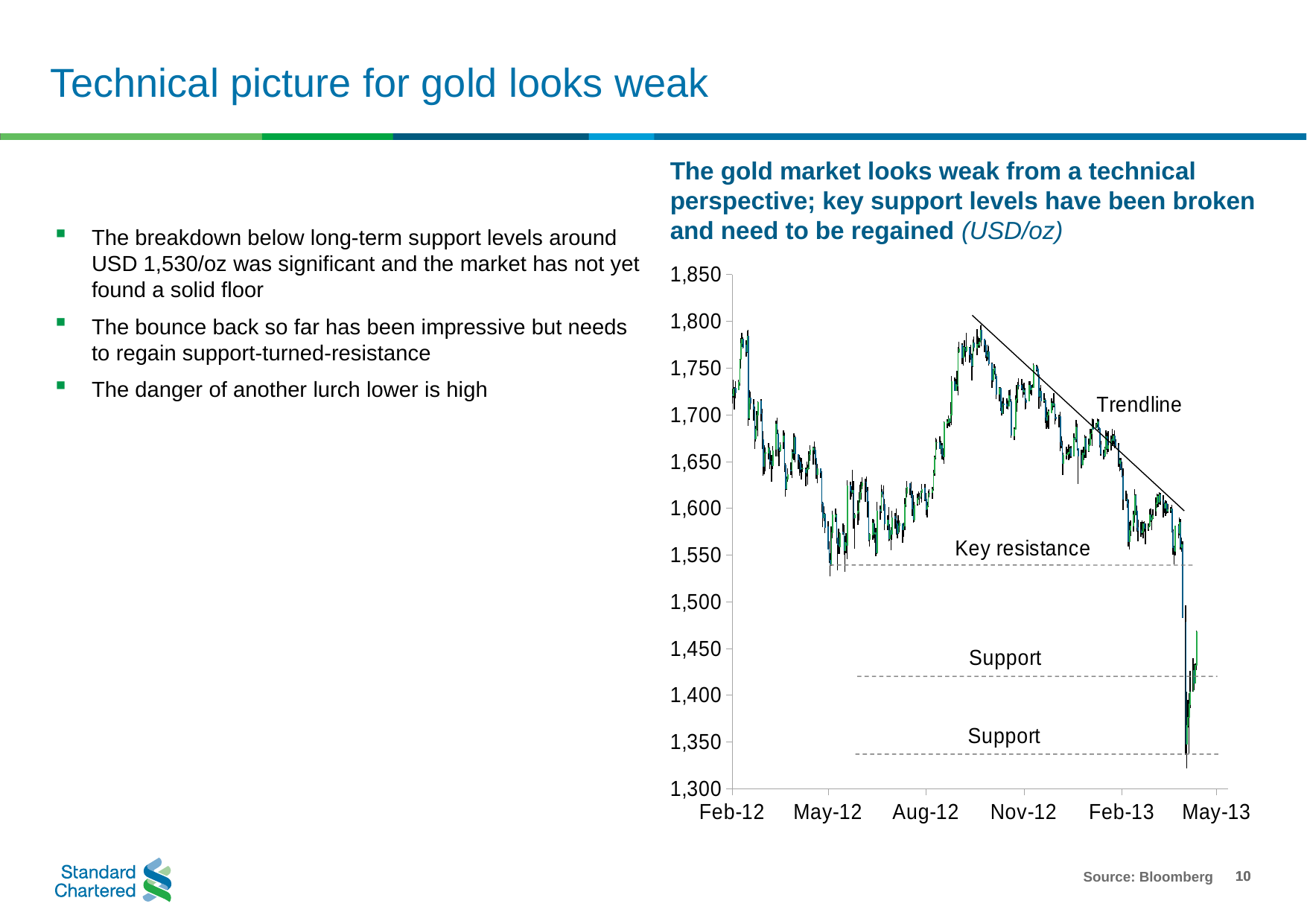
Is the lowest gold price reached in the chart (around Apr-13) greater or less than 1,400? less What is the highest value shown on the y axis? 1,850 What kind of chart is shown on the slide? stock chart Does the gold price rise or fall between Nov-12 and May-13? fall Is the peak gold price reached between Aug-12 and Nov-12 greater or less than 1,750? greater How many month labels are shown on the x axis? 6 Is the gold price at the start of the chart (Feb-12) greater or less than 1,700? greater Is the gold price higher around Oct-12 or around Apr-13? Oct-12 Between which two x-axis labels does the gold price reach its lowest point? Feb-13 and May-13 What is the unit shown in the chart title? USD/oz What is the source cited for the chart? Bloomberg